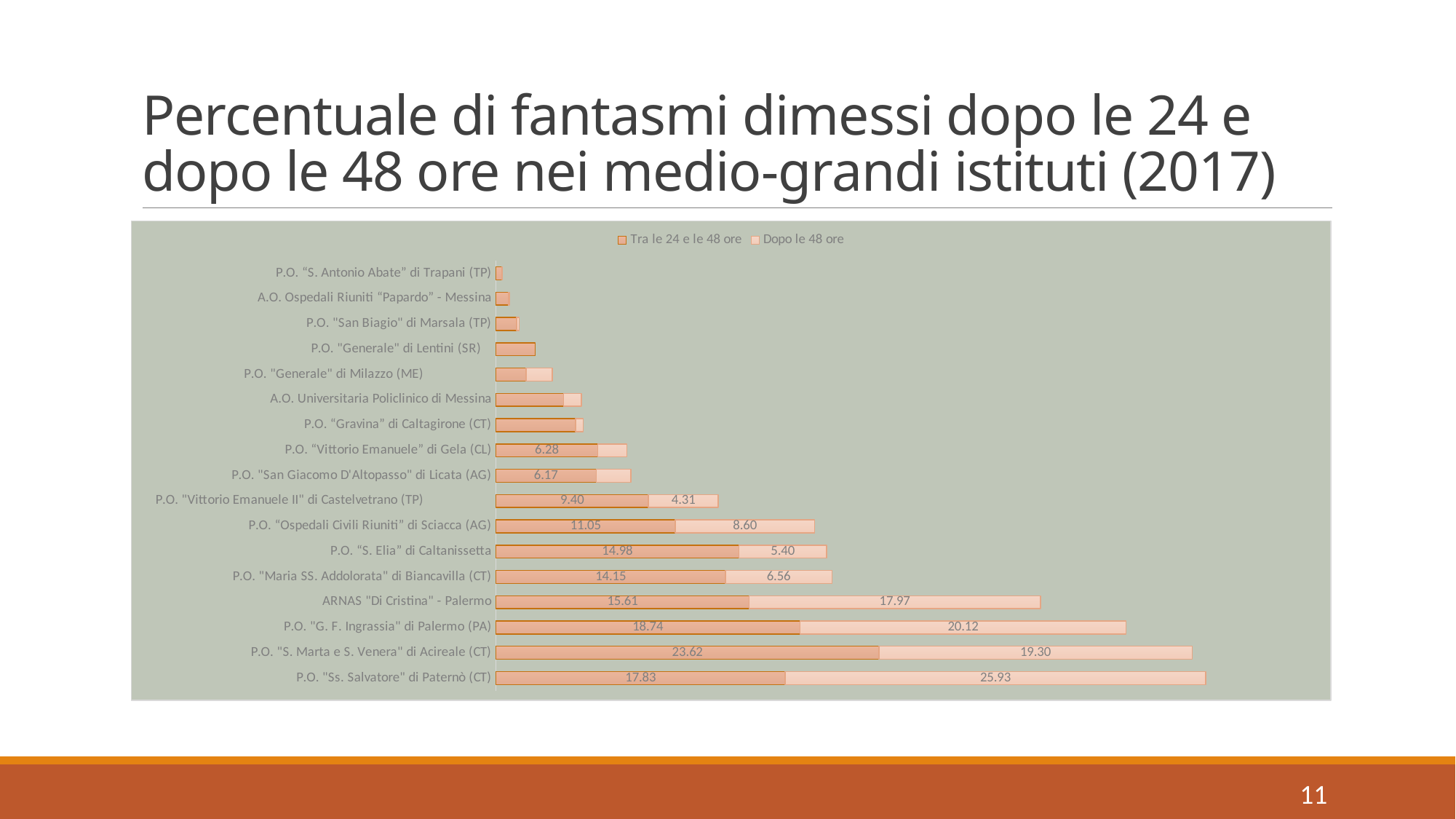
Which hospital has the highest "Dopo le 48 ore" value? P.O. "Ss. Salvatore" di Paternò (CT) How many series does the legend list? 2 How many hospitals (categories) are plotted in the chart? 17 What is the "Tra le 24 e le 48 ore" value for P.O. "S. Marta e S. Venera" di Acireale (CT)? 23.62 What type of chart is shown on the slide? Bar chart (stacked horizontal) What is the "Dopo le 48 ore" value for P.O. "Vittorio Emanuele II" di Castelvetrano (TP)? 4.31 What is the total of the stacked bar for P.O. "Ss. Salvatore" di Paternò (CT)? 43.76 What are the two series names shown in the legend? Tra le 24 e le 48 ore; Dopo le 48 ore Which hospital has the highest "Tra le 24 e le 48 ore" value? P.O. "S. Marta e S. Venera" di Acireale (CT) For P.O. "G. F. Ingrassia" di Palermo (PA), which is larger: the "Tra le 24 e le 48 ore" value or the "Dopo le 48 ore" value? Dopo le 48 ore What is the difference between the "Tra le 24 e le 48 ore" and "Dopo le 48 ore" values for P.O. "S. Elia" di Caltanissetta? 9.58 What is the "Dopo le 48 ore" value for P.O. "Ss. Salvatore" di Paternò (CT)? 25.93